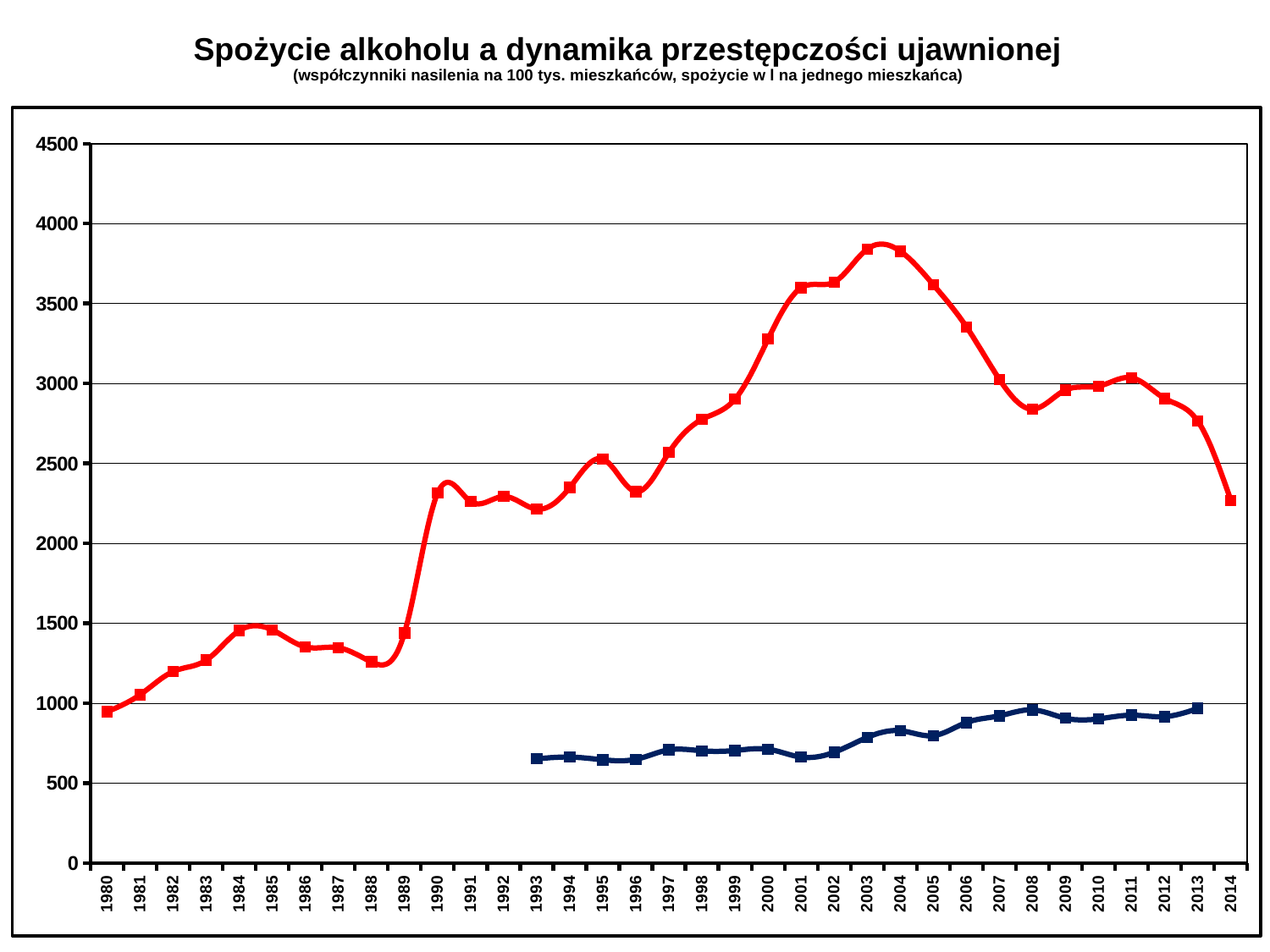
Is the value of the red line for 1990 greater or less than 2000? greater Is the value of the red line for 2014 greater or less than 2500? less Which year has the larger value on the red line, 2007 or 2008? 2007 How many years are labelled on the x axis of the chart? 35 Does the red line rise or fall between 2004 and 2008? fall How many lines (series) are plotted on the chart? 2 In which year does the red line reach its lowest value? 1980 What is the highest value shown on the y axis of the chart? 4500 What kind of chart is shown on the slide? line chart In which year does the blue line begin? 1993 Is the value of the red line for 2001 greater or less than 3500? greater